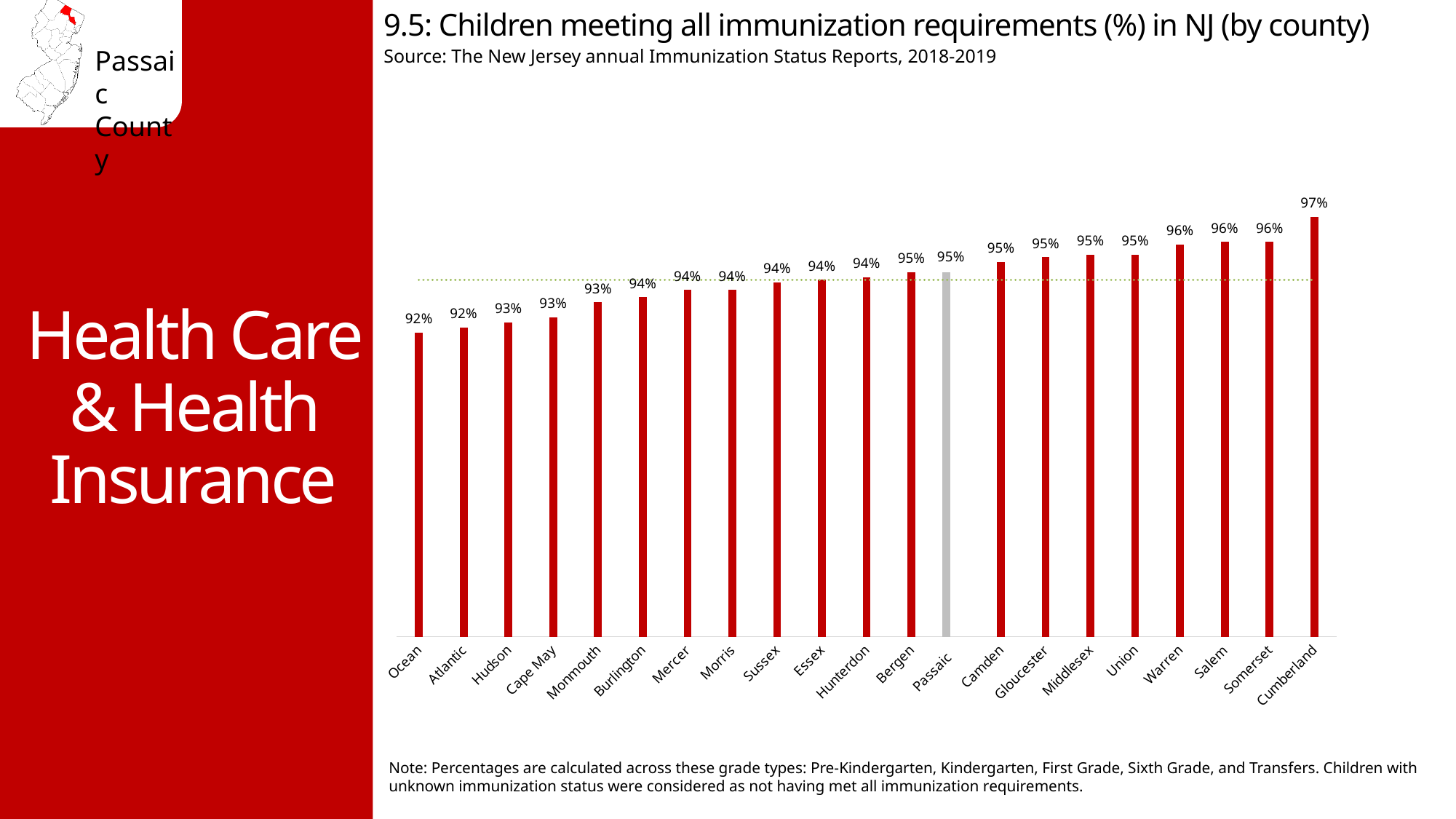
Which has a larger value, Cumberland or Atlantic? Cumberland Do the values rise or fall from left to right along the x axis? Rise How many counties are shown in the chart? 21 What is the difference between the values for Cumberland and Ocean? 5 percentage points What is the value for Ocean? 92% What kind of chart is this? Bar chart What is the value for Warren? 96% What is the value for Cumberland? 97% Which county's bar is coloured grey instead of red? Passaic What is the value for Monmouth? 93% What is the value for Passaic? 95% Which county has the highest value? Cumberland